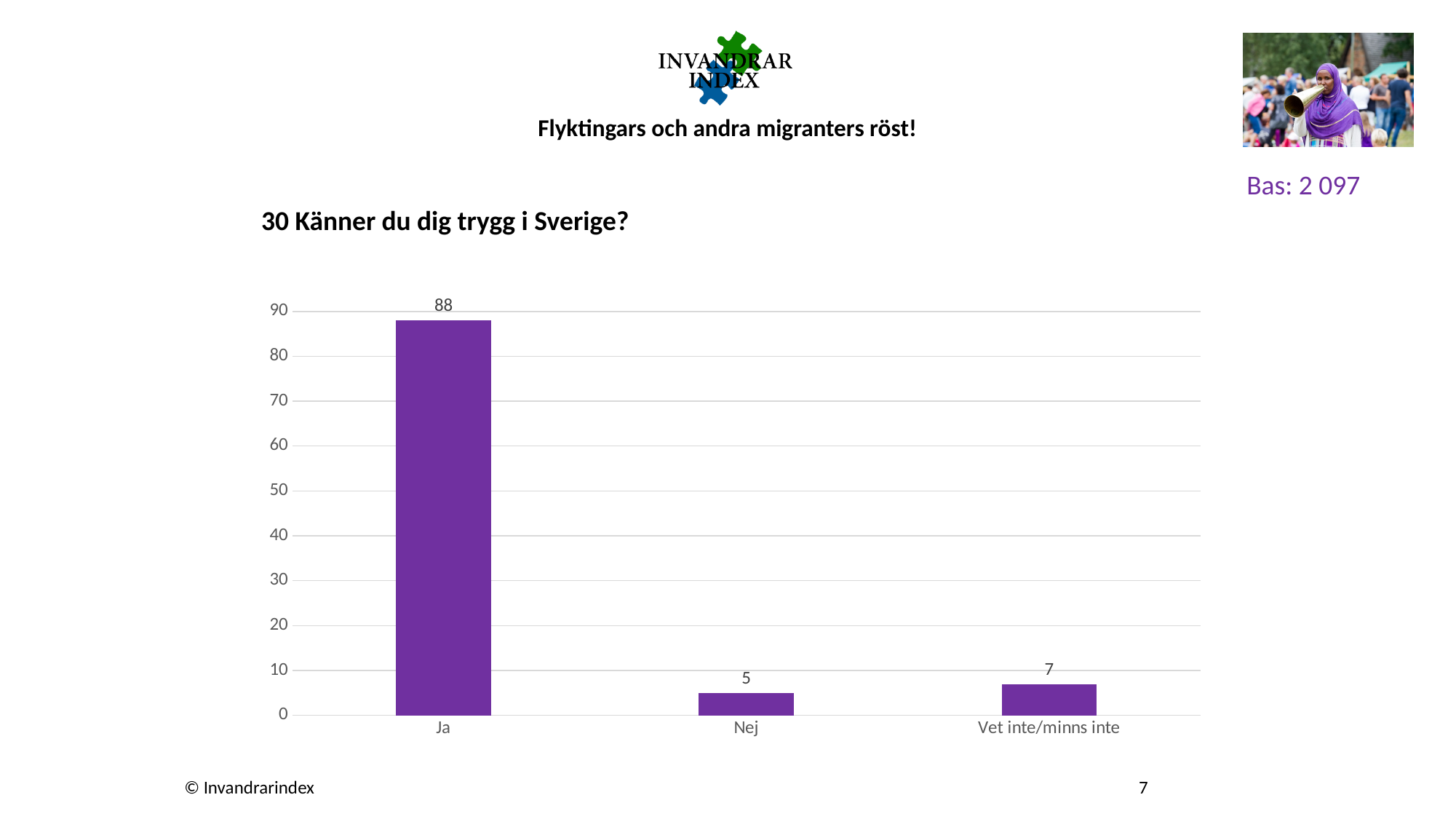
Which category has the lowest value? Nej What is the title of the chart? 30 Känner du dig trygg i Sverige? Which is larger, the value for "Nej" or the value for "Vet inte/minns inte"? Vet inte/minns inte How many categories are shown on the x axis? 3 What kind of chart is shown on the slide? bar chart What is the difference between the values for "Ja" and "Nej"? 83 Which category has the highest value? Ja Is the value for "Ja" greater or less than 80? greater What is the value for "Vet inte/minns inte"? 7 What is the difference between the values for "Vet inte/minns inte" and "Nej"? 2 What is the value for "Nej"? 5 What is the value for "Ja"? 88